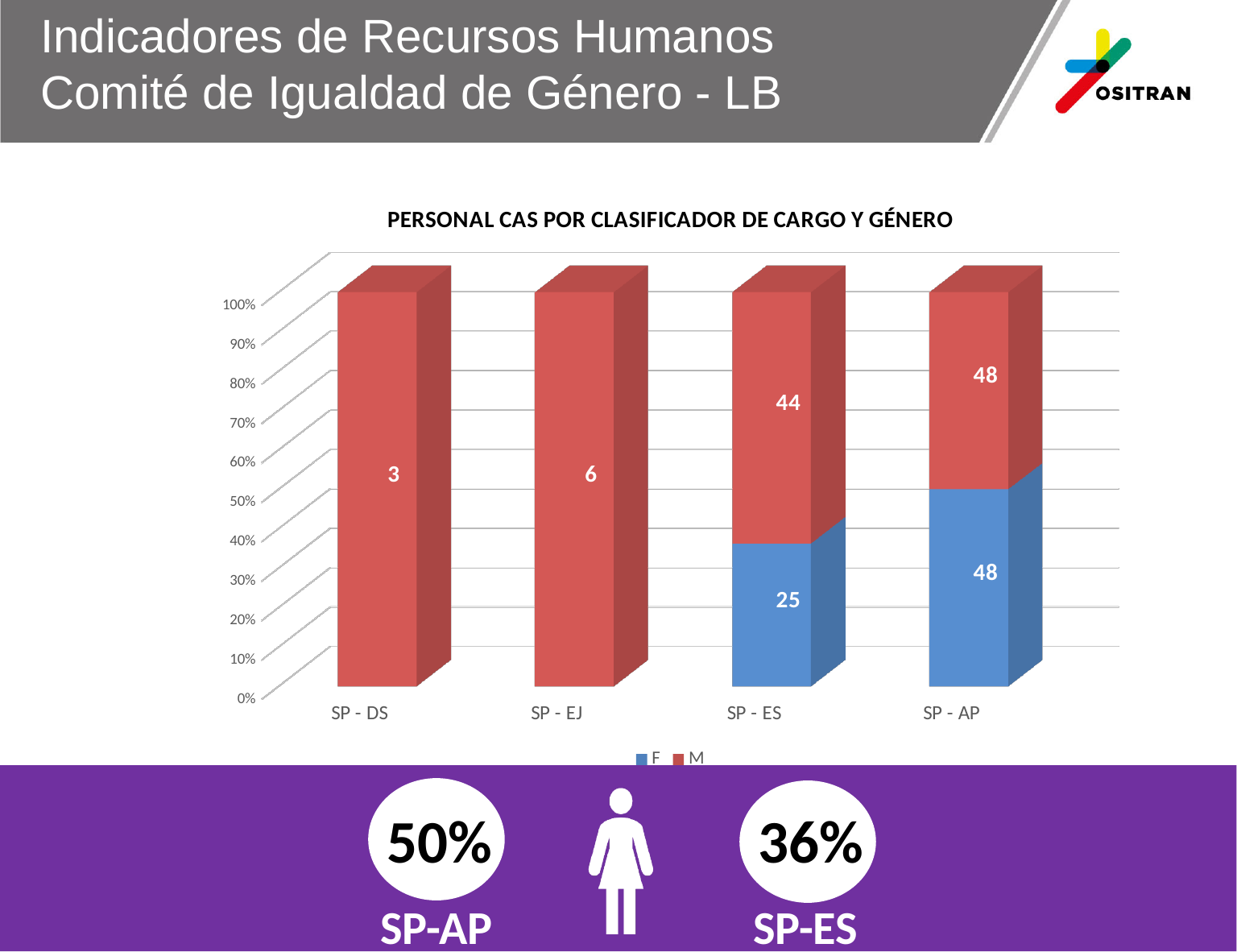
How many categories are shown on the x axis? 4 Is the F share of the SP - ES bar greater or less than 50%? less How many series does the legend list? 2 What is the value of the M series for SP - DS? 3 What is the value of the F series for SP - AP? 48 What is the value of the F series for SP - ES? 25 What is the sum of the F and M values for SP - AP? 96 For SP - ES, which series has the larger value, F or M? M What type of chart is shown on the slide? Stacked bar chart What is the value of the M series for SP - ES? 44 For SP - ES, what is the difference between the M value and the F value? 19 What is the value of the M series for SP - EJ? 6